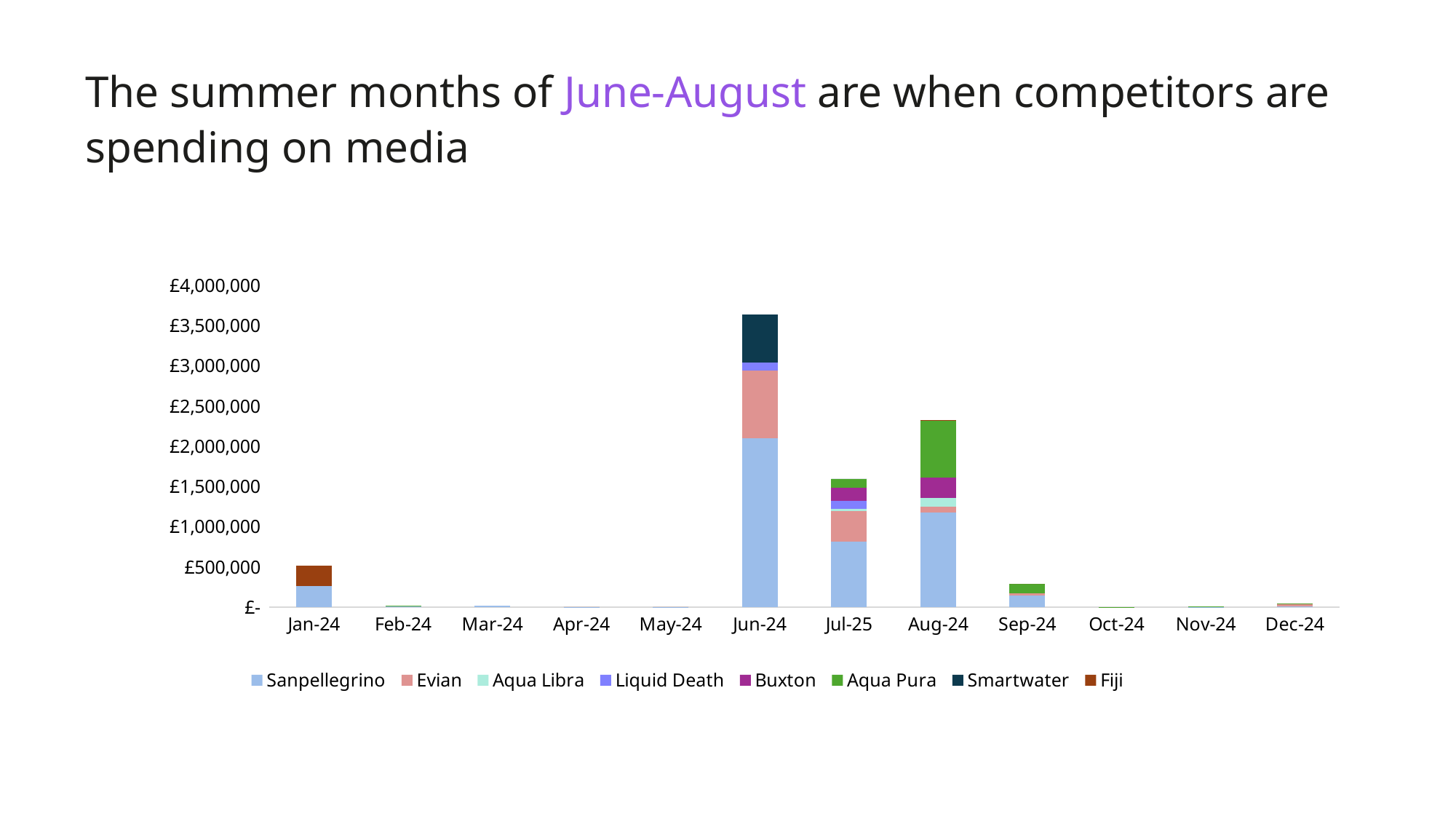
Which has the larger total spend, Jul-25 or Sep-24? Jul-25 Is the total value for Sep-24 greater or less than £500,000? less Is the total value for Aug-24 greater or less than £2,000,000? greater Is the total value for Jun-24 greater or less than £3,500,000? greater Which series is listed first in the chart's legend? Sanpellegrino How many series does the chart's legend list? 8 How many months are shown along the x axis of the chart? 12 What kind of chart is shown on the slide? Stacked bar chart Which month has the highest total media spend? Jun-24 Which has the larger total spend, Jun-24 or Aug-24? Jun-24